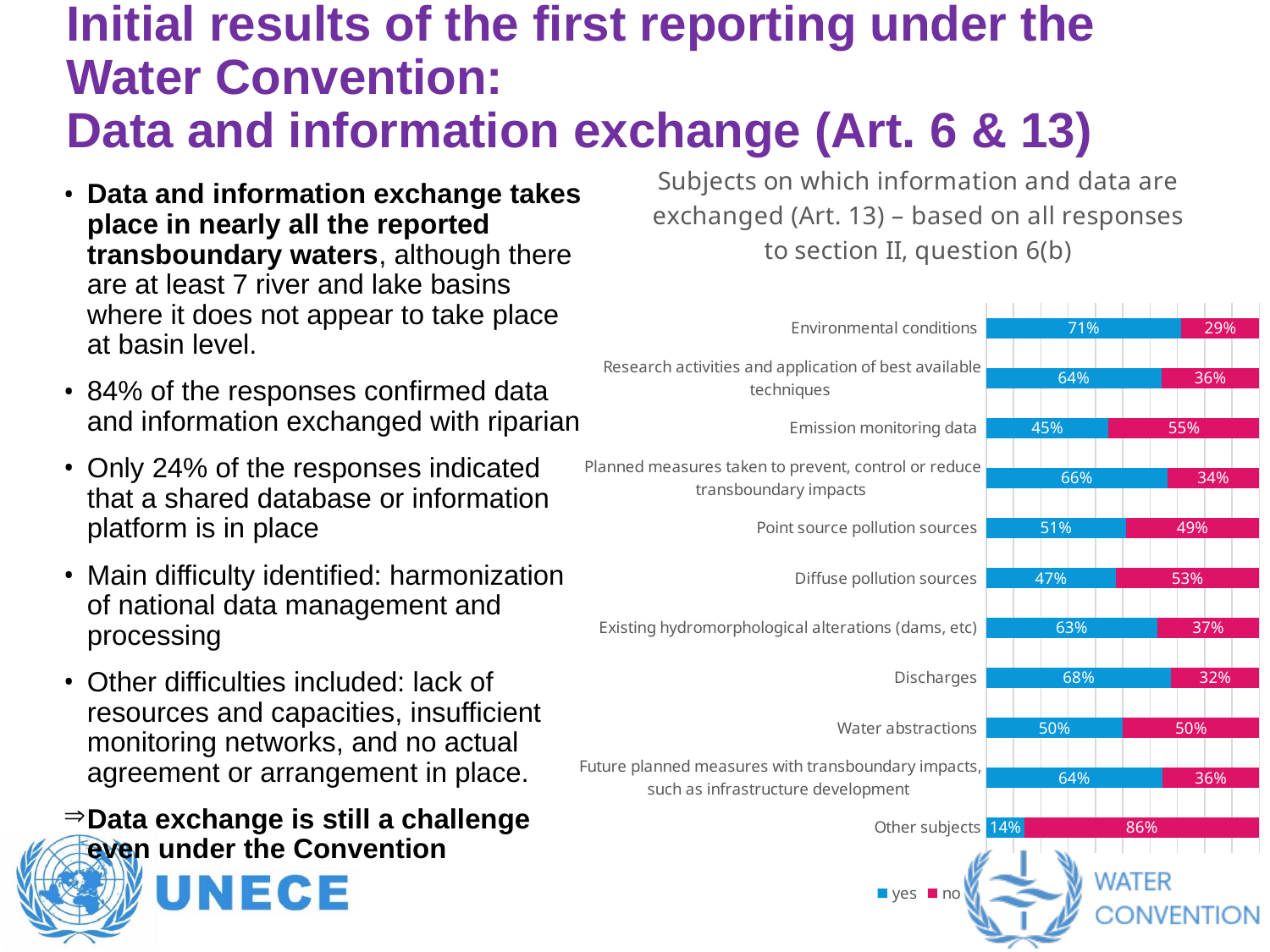
What is the "yes" value for Discharges? 68% How many categories are shown in the chart? 11 Which category has the highest "yes" share? Environmental conditions What kind of chart is shown on the slide? Stacked bar chart What is the "yes" value for Water abstractions? 50% What are the two legend entries of the chart? yes and no What is the "yes" value for Environmental conditions? 71% What is the "no" value for Emission monitoring data? 55% Which is larger: the "yes" value for Discharges or the "yes" value for Existing hydromorphological alterations (dams, etc)? Discharges How many series does the legend list? 2 Which category has the lowest "yes" share? Other subjects What is the difference between the "yes" and "no" values for Other subjects? 72 percentage points